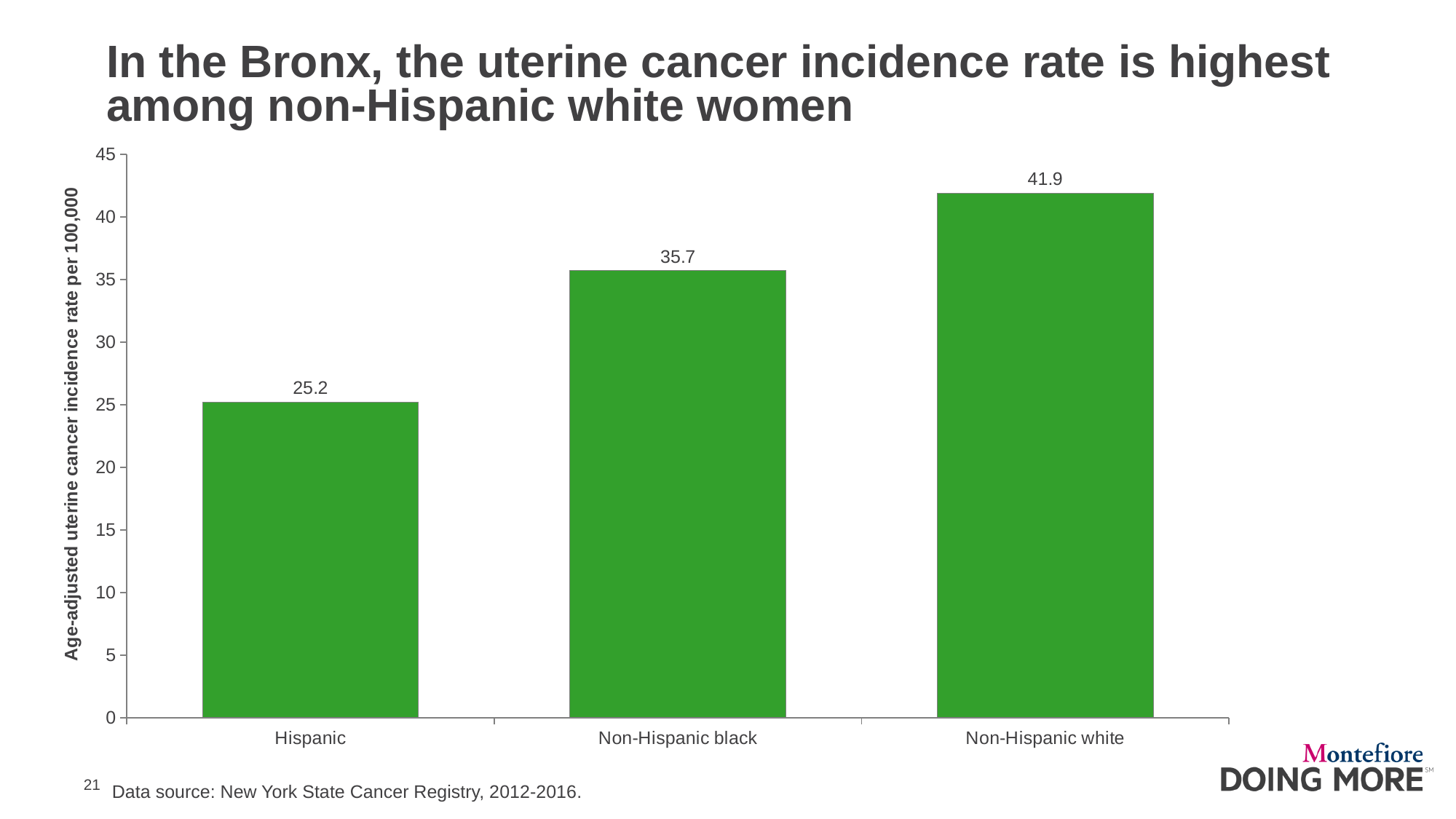
What is the difference between the incidence rates for non-Hispanic white and non-Hispanic black women? 6.2 What is the age-adjusted uterine cancer incidence rate per 100,000 for non-Hispanic white women? 41.9 Which group has the highest uterine cancer incidence rate? Non-Hispanic white What is the age-adjusted uterine cancer incidence rate per 100,000 for non-Hispanic black women? 35.7 Which is larger, the incidence rate for non-Hispanic black women or for Hispanic women? Non-Hispanic black What is the label of the y axis? Age-adjusted uterine cancer incidence rate per 100,000 How many groups are shown on the x axis? 3 What kind of chart is shown on the slide? Bar chart Is the value for non-Hispanic black women greater or less than 30? greater Which group has the lowest uterine cancer incidence rate? Hispanic What is the age-adjusted uterine cancer incidence rate per 100,000 for Hispanic women? 25.2 What is the difference between the incidence rates for non-Hispanic white and Hispanic women? 16.7